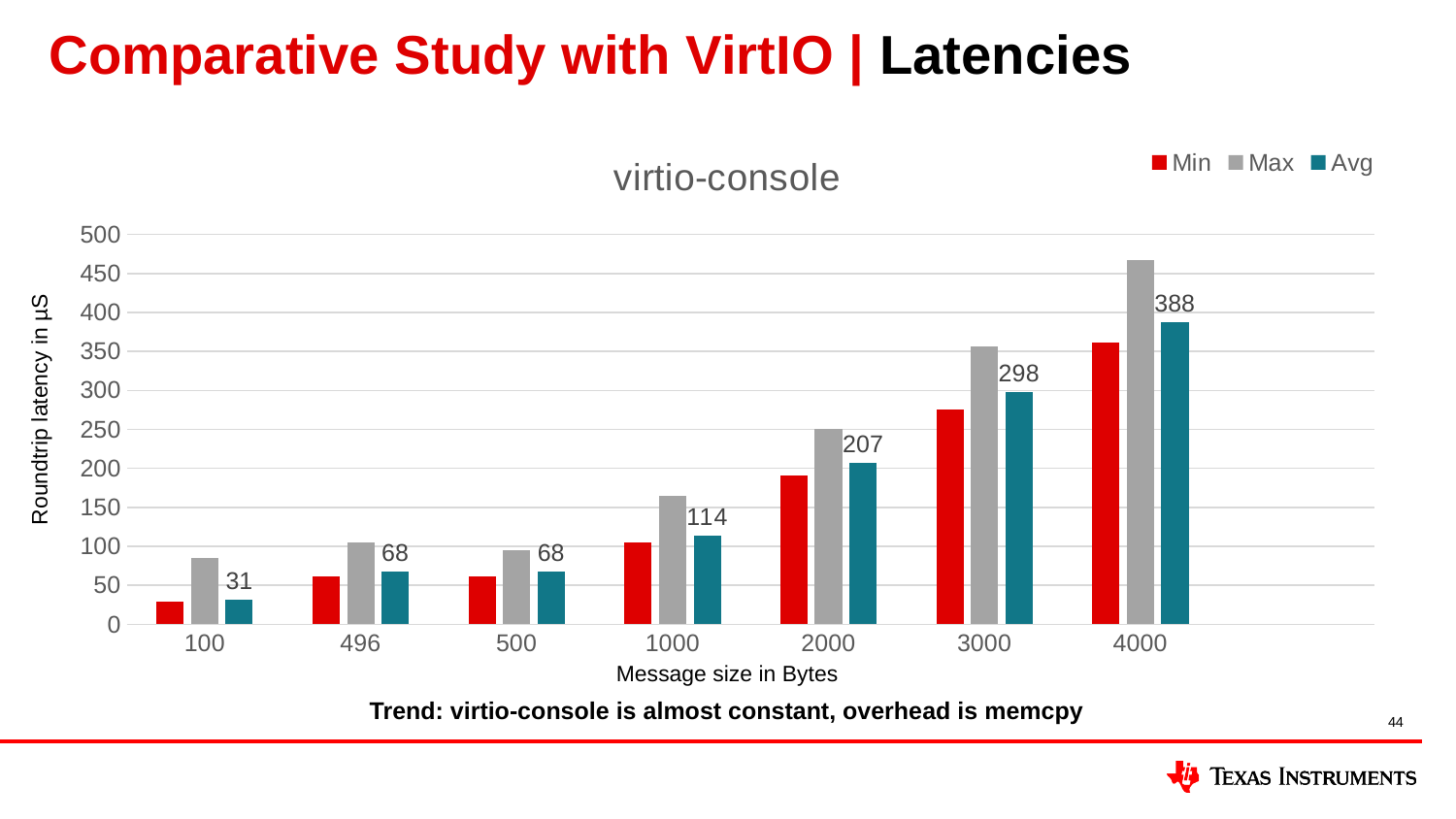
What is the difference between the Avg latency at 3000 bytes and at 1000 bytes? 184 What is the Avg roundtrip latency for a message size of 100 bytes? 31 What is the Avg roundtrip latency for a message size of 2000 bytes? 207 Which message size has the highest Avg roundtrip latency? 4000 How many message sizes are shown on the x axis? 7 Is the Max latency for a message size of 4000 bytes greater or less than 450? greater Is the Avg latency larger at 2000 bytes or at 3000 bytes? 3000 bytes Which message size has the lowest Avg roundtrip latency? 100 What is the Avg roundtrip latency for a message size of 4000 bytes? 388 What kind of chart is shown on the slide? bar chart Is the Min latency for a message size of 1000 bytes greater or less than 150? less How many series does the legend list? 3